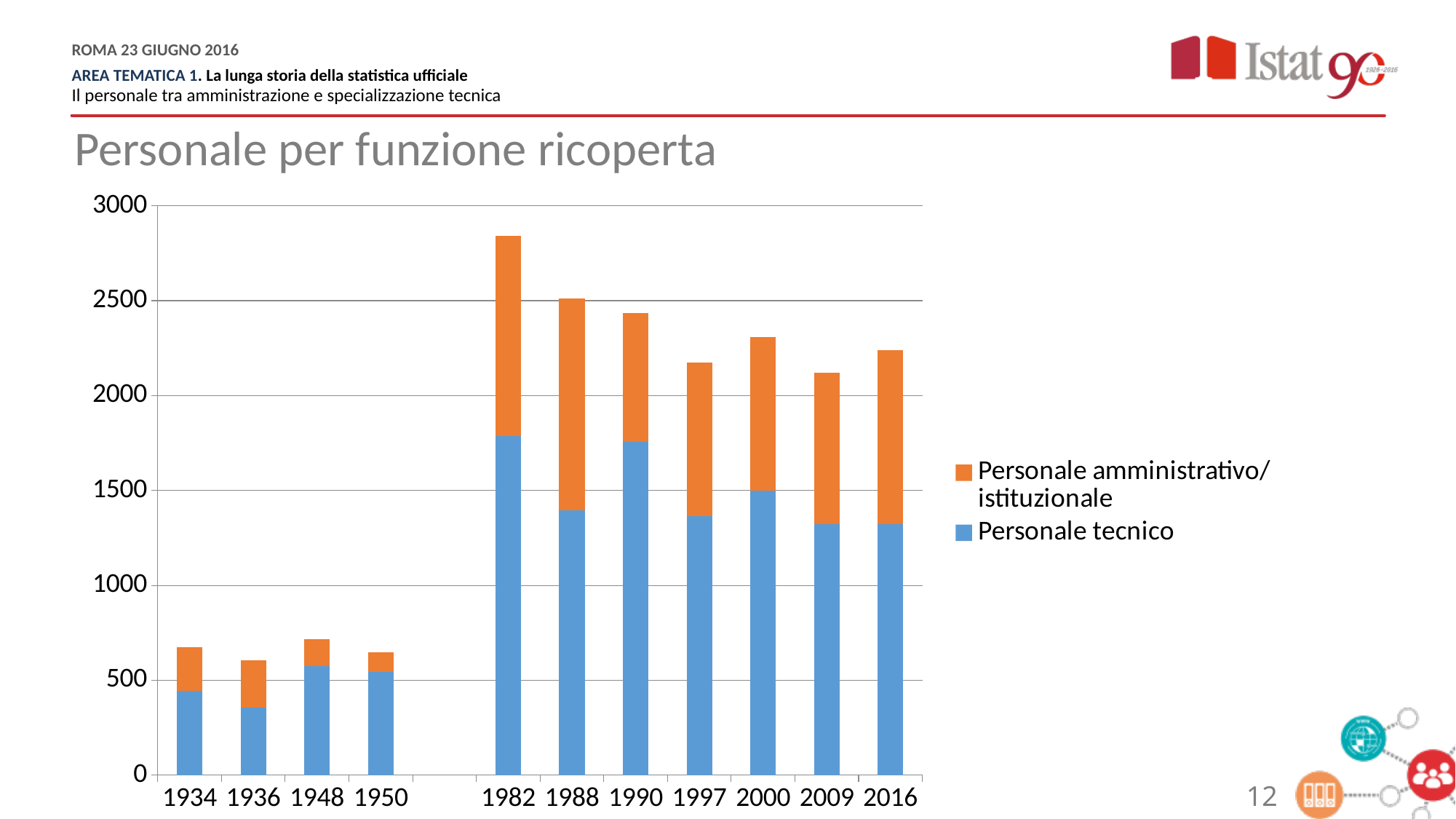
Is the total bar for 1982 greater or less than 2500? greater Which year has the highest total bar? 1982 What kind of chart is shown on the slide? stacked bar chart What is the title of the chart? Personale per funzione ricoperta Is the total bar for 1934 greater or less than 1000? less How many years are shown on the x axis of the chart? 11 Which year has the lowest total bar? 1936 Do the total bars rise or fall from 1982 to 1997? fall How many series does the legend list? 2 Which is larger, the total bar for 1982 or the total bar for 1988? 1982 Is the value of Personale tecnico for 1936 greater or less than 500? less